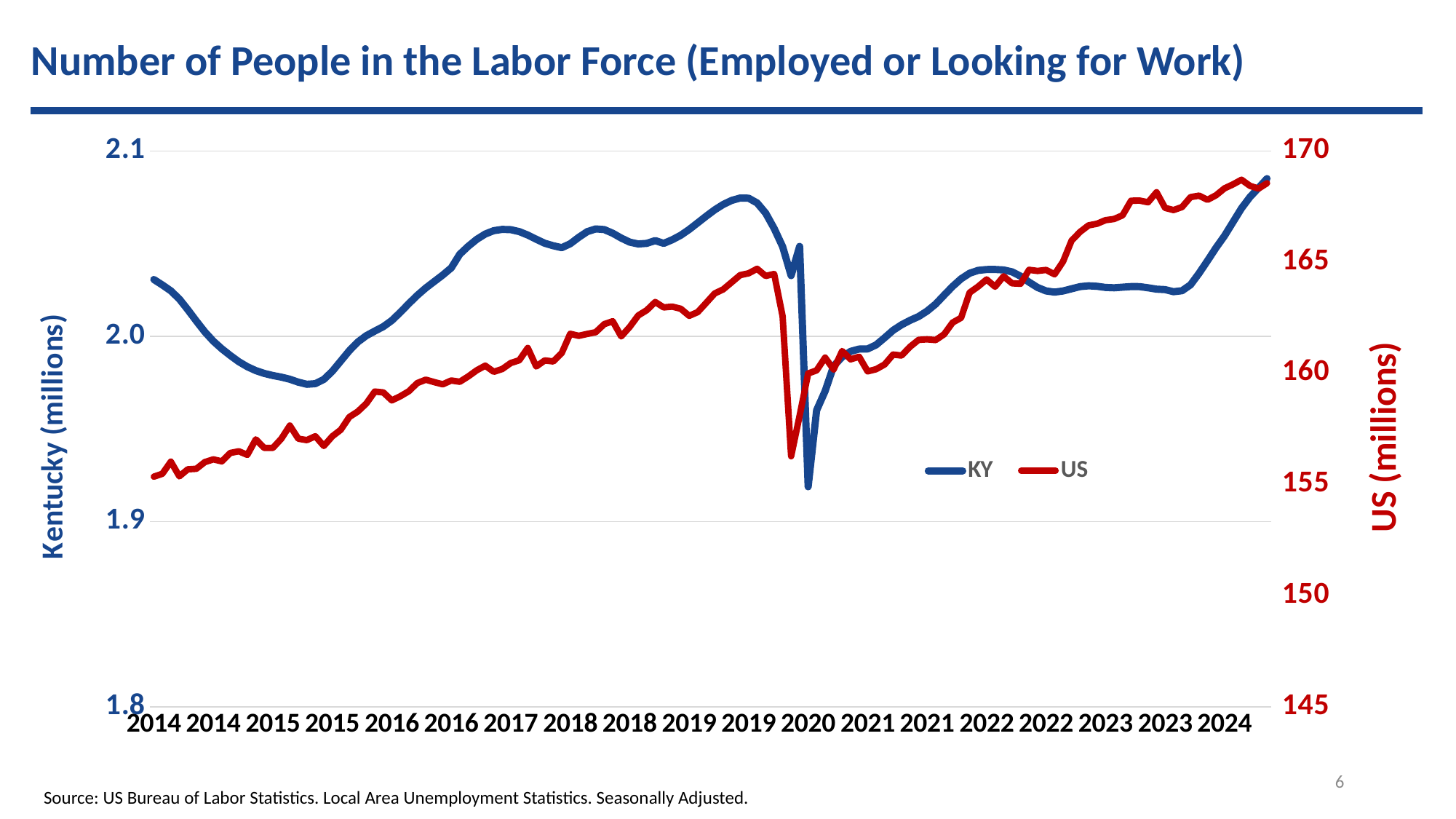
Is the US value at its lowest point in 2020 greater or less than 160? less Is the KY value at its lowest point in 2020 greater or less than 2.0? less How many series does the legend list? 2 Does the KY series rise or fall between the start of 2014 and the end of 2015? fall What kind of chart is shown on the slide? line chart Is the KY value at the start of 2014 greater or less than 2.0? greater Does the US series generally rise or fall from 2014 to 2024? rise What are the two series named in the legend? KY and US What is the label of the left vertical axis? Kentucky (millions)